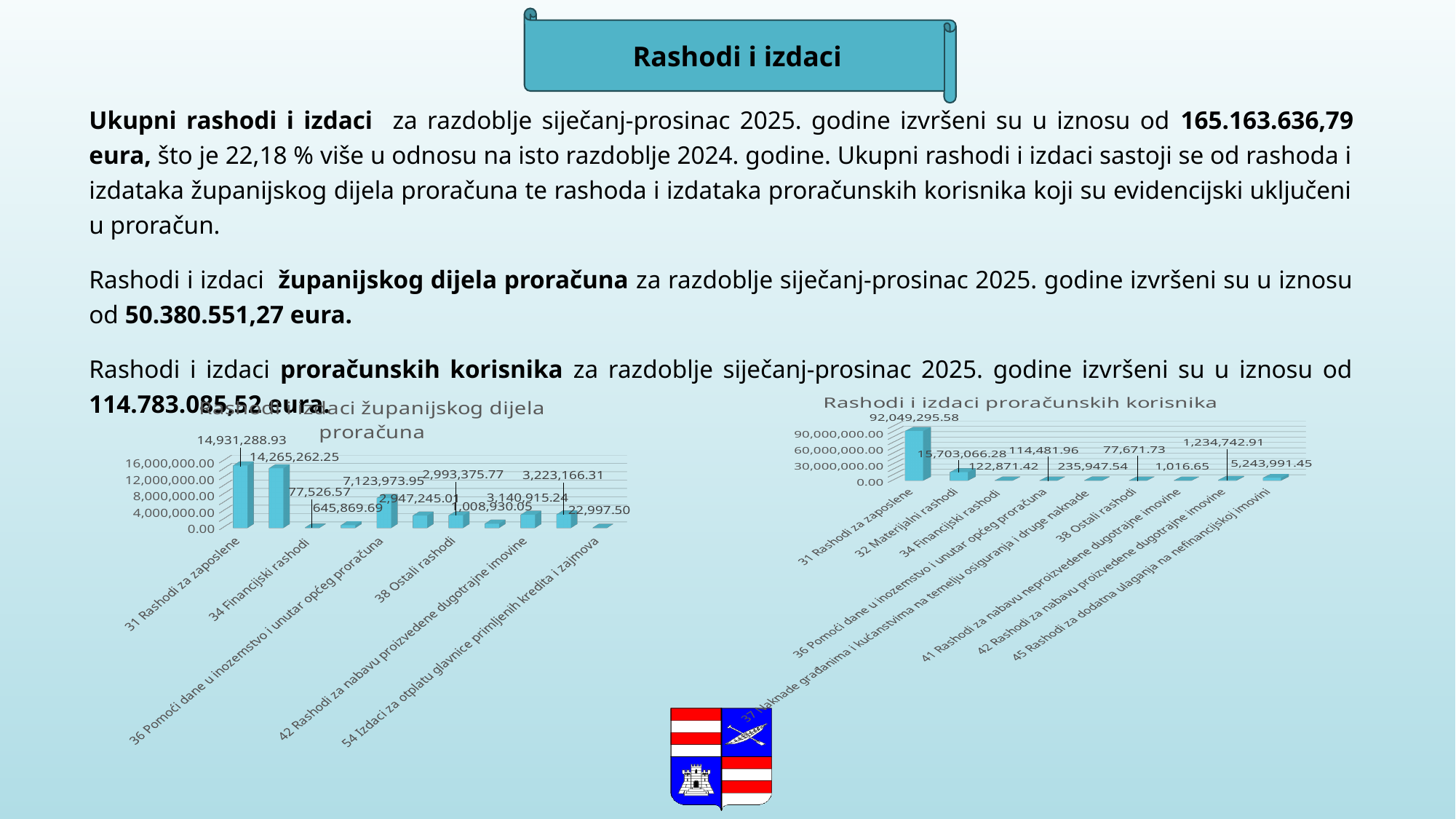
In the chart 'Rashodi i izdaci proračunskih korisnika', what is the value for '45 Rashodi za dodatna ulaganja na nefinancijskoj imovini'? 5,243,991.45 In the chart 'Rashodi i izdaci proračunskih korisnika', what is the difference between '31 Rashodi za zaposlene' and '32 Materijalni rashodi'? 76,346,229.30 In the chart 'Rashodi i izdaci proračunskih korisnika', what is the value for '31 Rashodi za zaposlene'? 92,049,295.58 In the chart 'Rashodi i izdaci županijskog dijela proračuna' (left chart), what is the value for '54 Izdaci za otplatu glavnice primljenih kredita i zajmova'? 22,997.50 In the chart 'Rashodi i izdaci županijskog dijela proračuna' (left chart), what is the value for '31 Rashodi za zaposlene'? 14,931,288.93 In the chart 'Rashodi i izdaci proračunskih korisnika', which is larger: '42 Rashodi za nabavu proizvedene dugotrajne imovine' or '45 Rashodi za dodatna ulaganja na nefinancijskoj imovini'? 45 Rashodi za dodatna ulaganja na nefinancijskoj imovini How many bars are plotted in the left chart, 'Rashodi i izdaci županijskog dijela proračuna'? 11 In the chart 'Rashodi i izdaci proračunskih korisnika', which category has the lowest value? 41 Rashodi za nabavu neproizvedene dugotrajne imovine In the chart 'Rashodi i izdaci proračunskih korisnika', what is the value for '32 Materijalni rashodi'? 15,703,066.28 How many categories are plotted in the chart 'Rashodi i izdaci proračunskih korisnika'? 9 What kind of chart is the left chart, 'Rashodi i izdaci županijskog dijela proračuna'? bar chart In the chart 'Rashodi i izdaci proračunskih korisnika', which category has the highest value? 31 Rashodi za zaposlene